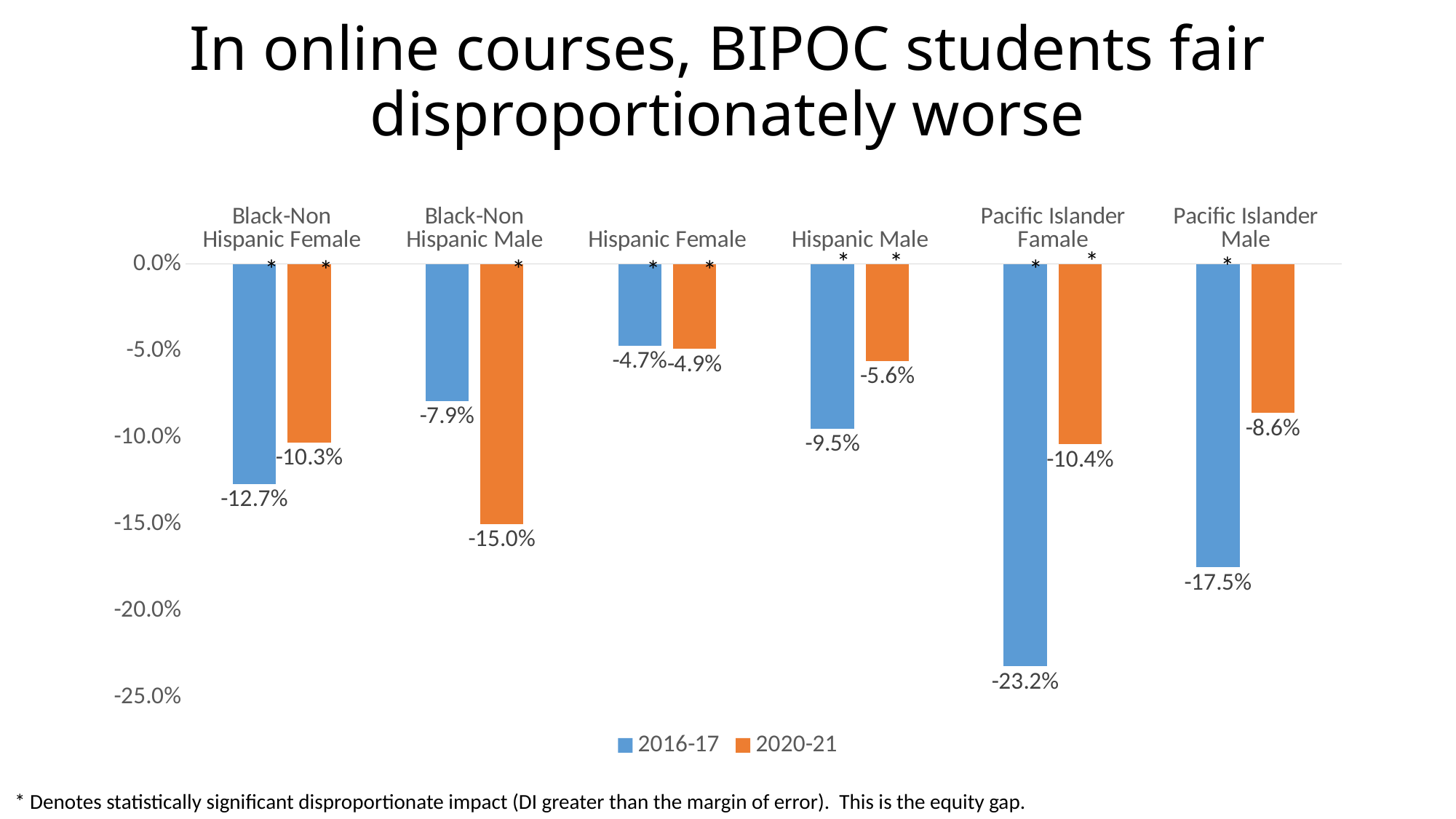
Which series is shown in blue? 2016-17 What is the 2016-17 value for Black-Non Hispanic Female? -12.7% How many categories are shown on the x axis? 6 Which category has the 2020-21 value closest to zero? Hispanic Female How many series does the legend list? 2 What kind of chart is shown on the slide? Bar chart Which category has the most negative 2016-17 value? Pacific Islander Famale What is the 2020-21 value for Pacific Islander Male? -8.6% What is the 2016-17 value for Hispanic Male? -9.5% What is the 2020-21 value for Black-Non Hispanic Male? -15.0% What is the difference between the 2016-17 and 2020-21 values for Pacific Islander Famale? 12.8 percentage points Which is more negative for Black-Non Hispanic Male: the 2016-17 value or the 2020-21 value? 2020-21